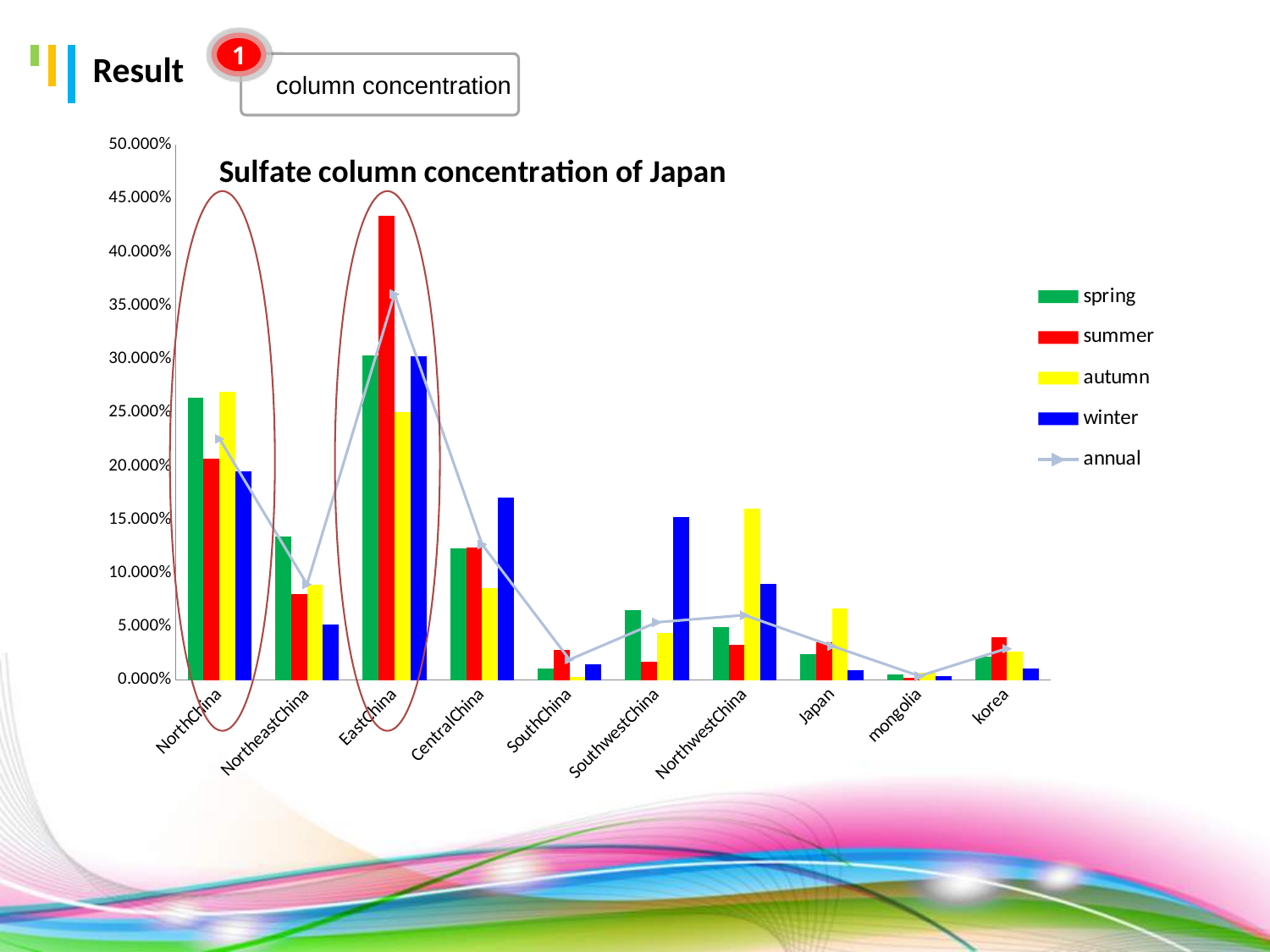
What is the title of the chart? Sulfate column concentration of Japan Which category has the highest winter value? EastChina Which series is drawn as a line rather than bars? annual What kind of chart is this? bar chart (with a line for annual) Does the annual line rise or fall from EastChina to SouthChina? fall Is the summer value for EastChina greater or less than 40.000%? greater Is the summer value for NortheastChina greater or less than 10.000%? less How many categories are shown on the x axis? 10 Is the winter value for SouthwestChina greater or less than 10.000%? greater Which is larger for SouthwestChina, the spring value or the winter value? winter Which category has the highest summer value? EastChina How many series does the legend list? 5